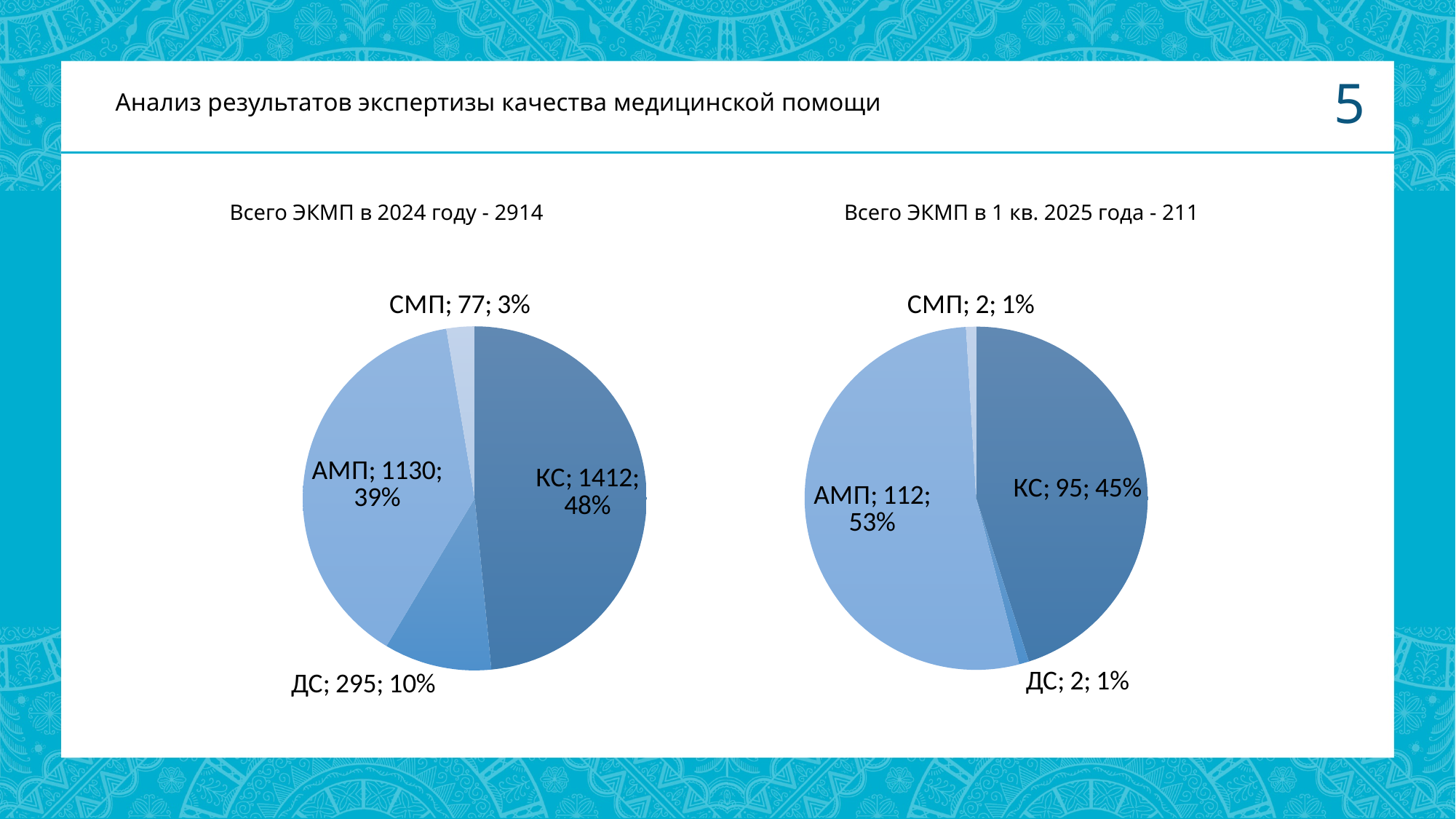
In the chart titled 'Всего ЭКМП в 2024 году - 2914', what is the difference between the values for КС and АМП? 282 What is the title of the chart on the left of the slide? Всего ЭКМП в 2024 году - 2914 In the chart titled 'Всего ЭКМП в 2024 году - 2914', what is the value for КС? 1412 In the chart titled 'Всего ЭКМП в 1 кв. 2025 года - 211', what is the value for АМП? 112 In the chart titled 'Всего ЭКМП в 2024 году - 2914', what share of the pie does АМП have? 39% How many categories are shown in the chart titled 'Всего ЭКМП в 2024 году - 2914'? 4 In the chart titled 'Всего ЭКМП в 1 кв. 2025 года - 211', which is larger, the value for КС or the value for ДС? КС In the chart titled 'Всего ЭКМП в 1 кв. 2025 года - 211', which category has the largest value? АМП In the chart titled 'Всего ЭКМП в 2024 году - 2914', which category has the largest value? КС What kind of chart is the chart on the right of the slide? Pie chart In the chart titled 'Всего ЭКМП в 1 кв. 2025 года - 211', what share of the pie does КС have? 45% In the chart titled 'Всего ЭКМП в 2024 году - 2914', which category has the smallest value? СМП